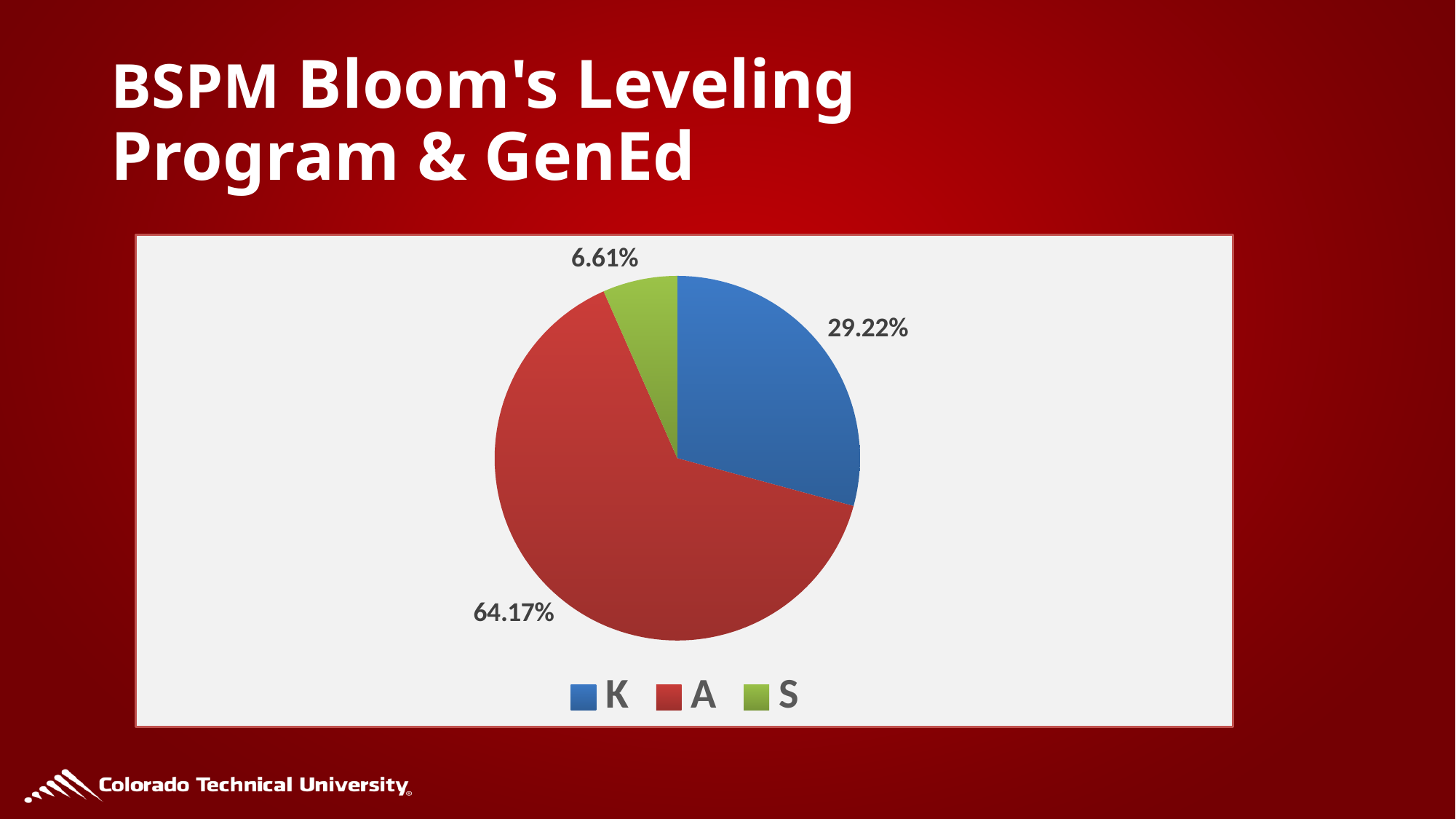
What type of chart is shown on the slide? pie chart What percentage of the pie does the K slice represent? 29.22% What is the difference in percentage points between the A slice and the K slice? 34.95 How many slices does the pie chart have? 3 How many entries does the legend list? 3 What is the title of the slide containing the pie chart? BSPM Bloom's Leveling Program & GenEd Which is larger, the share for K or the share for S? K Which category has the smallest share of the pie? S Which category has the largest share of the pie? A What percentage of the pie does the S slice represent? 6.61% What percentage of the pie does the A slice represent? 64.17% What colour is the slice for category A? red